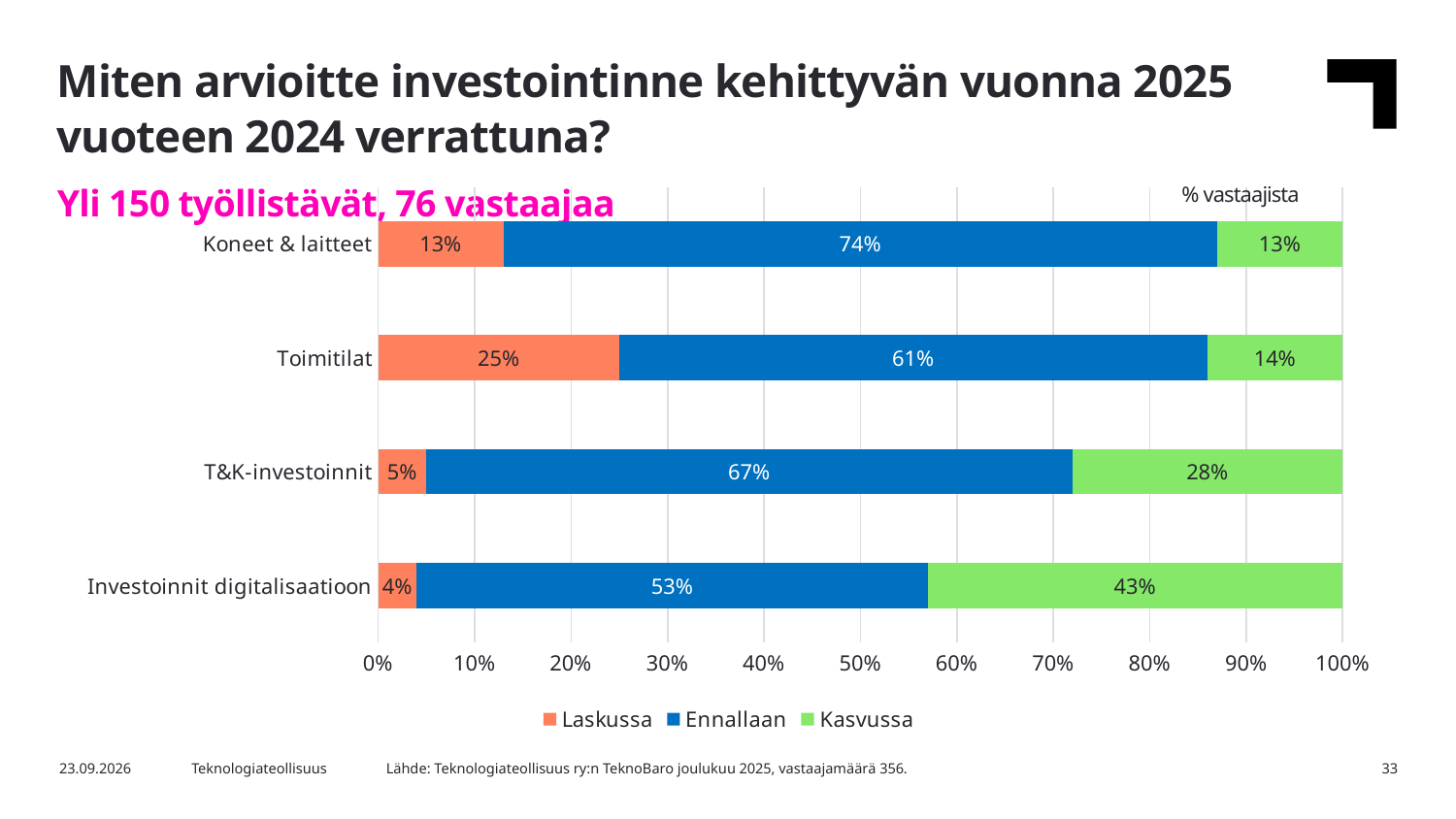
What percentage of respondents expect Koneet & laitteet investments to stay Ennallaan? 74% What is the Kasvussa value for Investoinnit digitalisaatioon? 43% What is the total of the stacked bar for Toimitilat? 100% Which is larger: the Ennallaan value for Koneet & laitteet or for T&K-investoinnit? Koneet & laitteet What is the difference between the Kasvussa values for T&K-investoinnit and Toimitilat? 14 percentage points How many series does the legend list? 3 How many categories are shown on the chart? 4 Which category has the lowest Laskussa share? Investoinnit digitalisaatioon Which category has the highest Kasvussa share? Investoinnit digitalisaatioon Which series is shown in green in the legend? Kasvussa What is the Laskussa value for Toimitilat? 25% What kind of chart is shown on the slide? Stacked bar chart